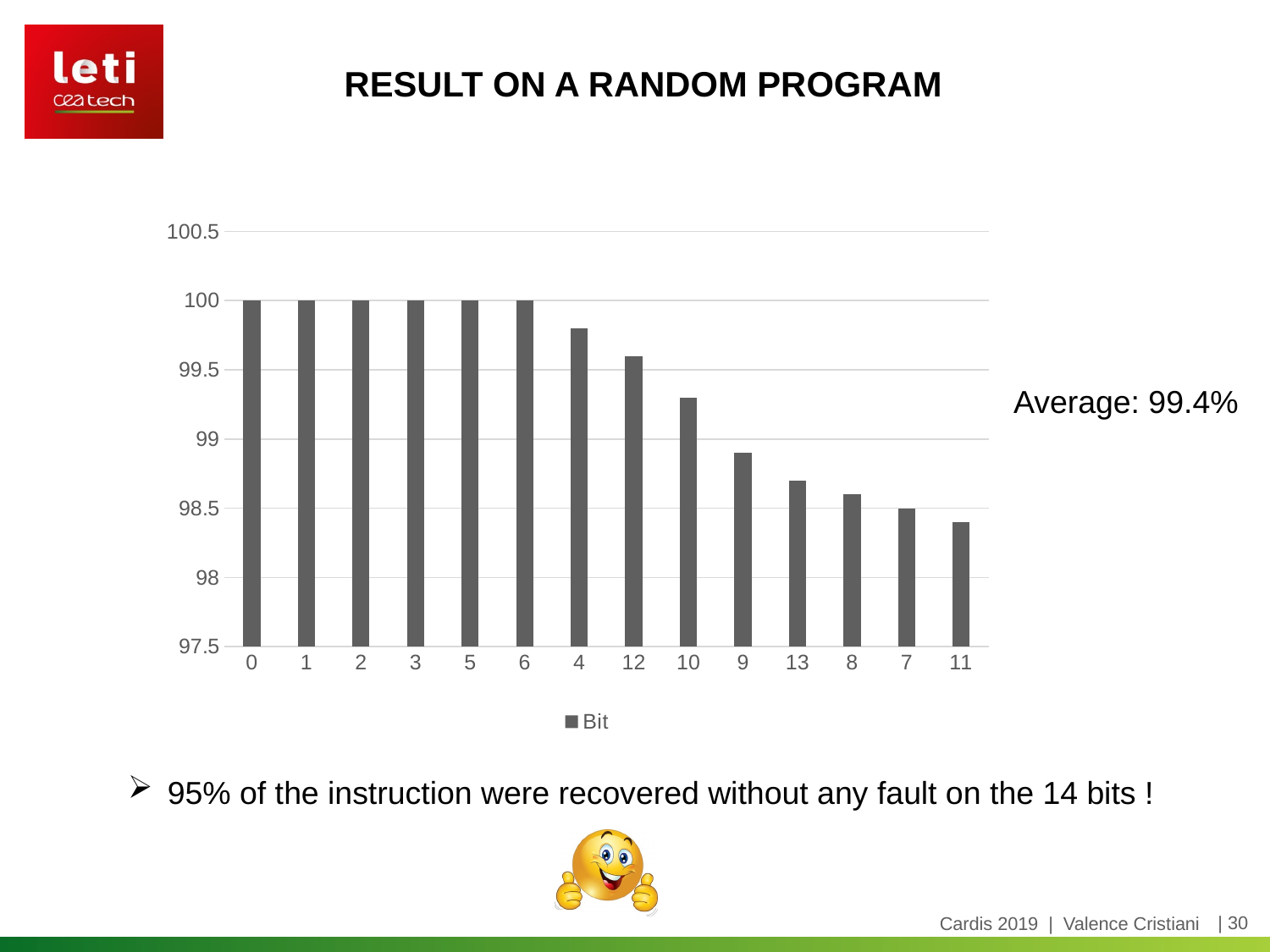
Is the value for bit 4 greater or less than 99.5? greater What is the value for bit 7? 98.5 Is the value for bit 9 greater or less than 99? less Do the bar values rise or fall moving from left to right along the x axis? fall How many series does the chart legend list? 1 Which bit has the lowest value in the chart? 11 What kind of chart is shown on the slide? bar chart What is the value for bit 0? 100 How many bars (bit categories) are plotted in the chart? 14 Which has the larger value, bit 4 or bit 11? bit 4 Is the value for bit 11 greater or less than 98.5? less What is the name of the series shown in the legend? Bit